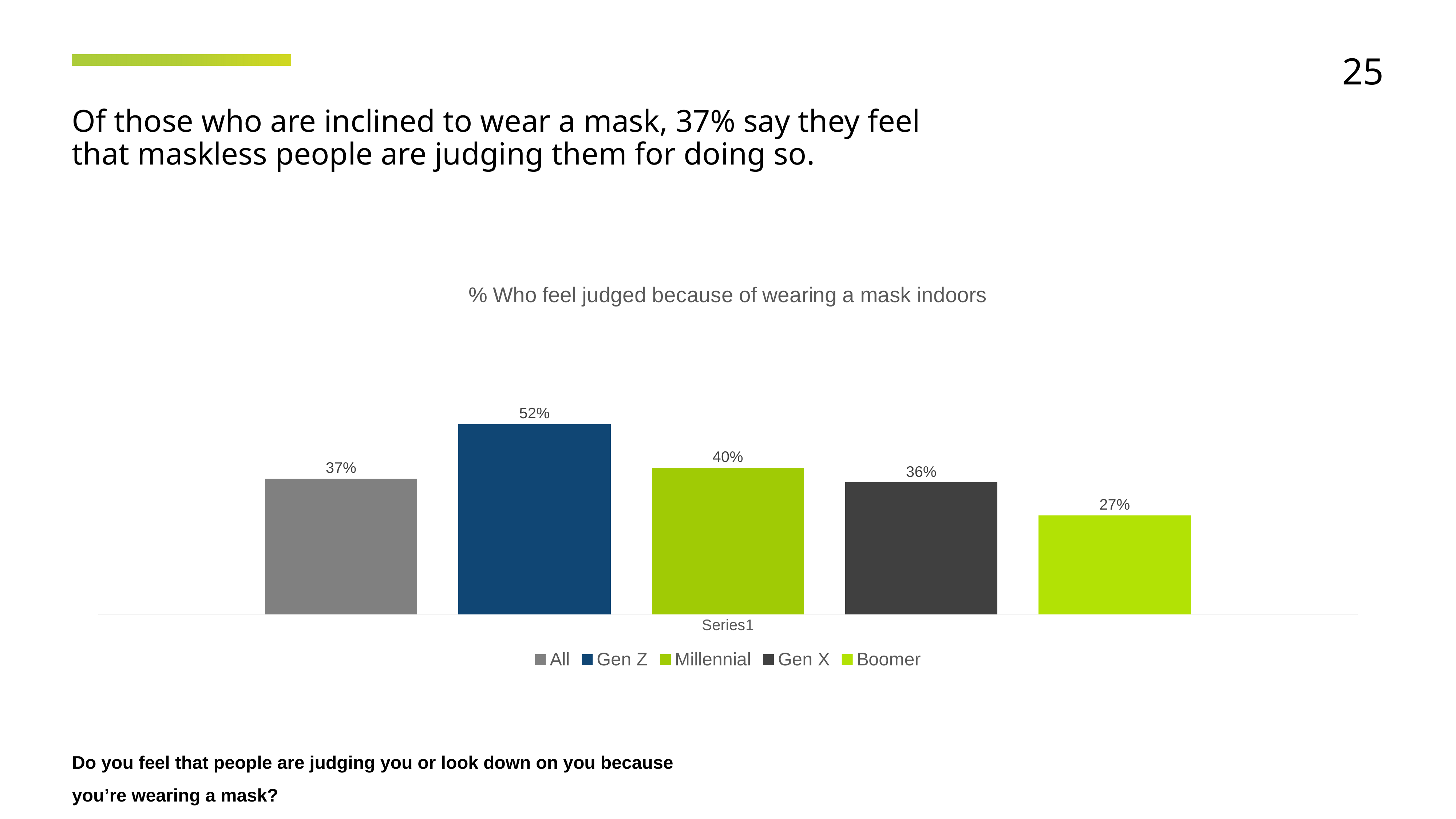
Which group has the highest value? Gen Z Which group has the lowest value? Boomer What is the difference between the Millennial and Gen X values? 4% Which is larger, the value for All or the value for Gen X? All What is the value for Gen X? 36% What is the value for Gen Z? 52% What is the difference between the Gen Z and Boomer values? 25% What is the value for Boomer? 27% What is the value for Millennial? 40% How many series does the legend list? 5 What is the title of the chart? % Who feel judged because of wearing a mask indoors What kind of chart is shown? Bar chart